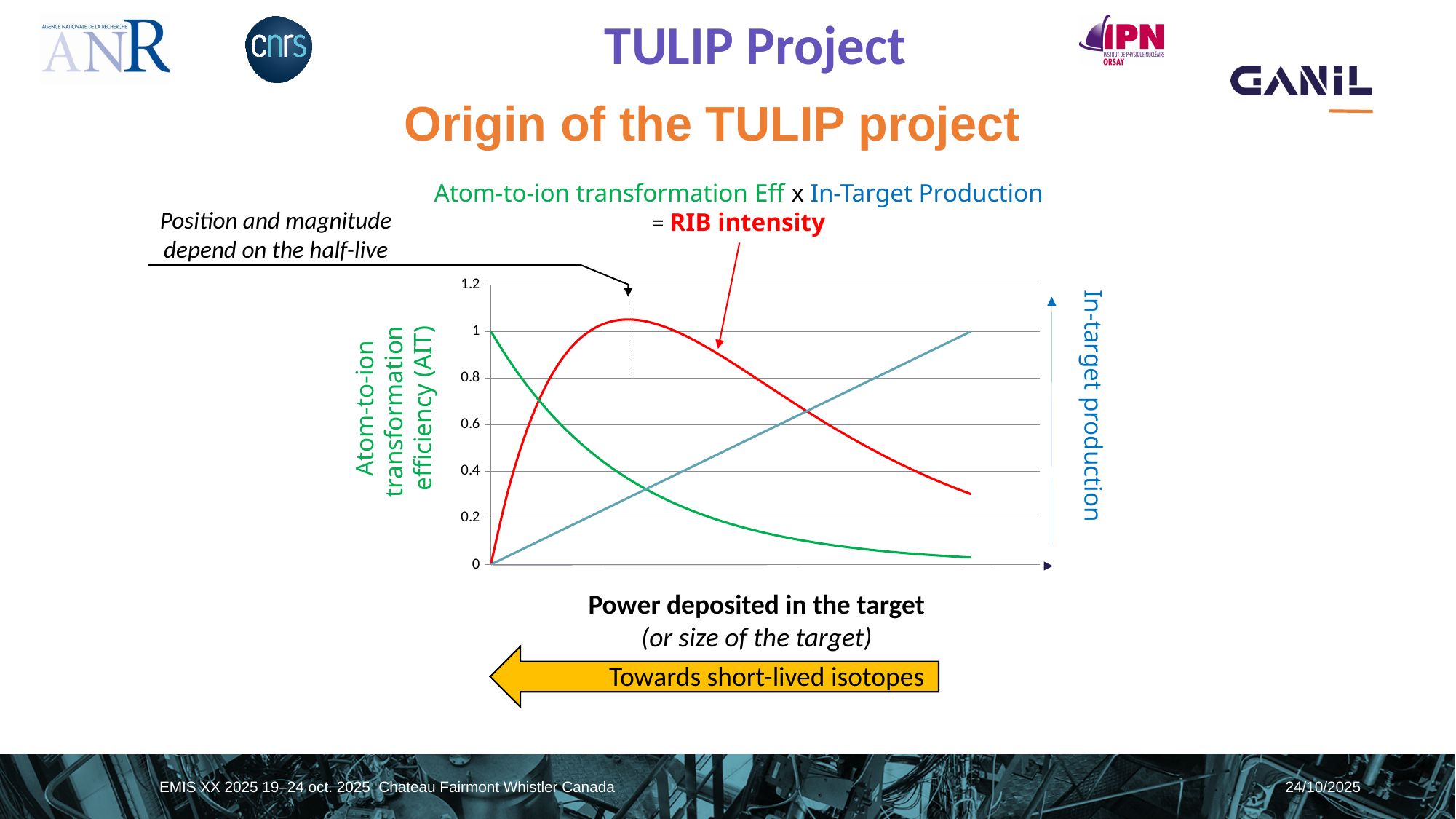
Does the green Atom-to-ion transformation efficiency curve rise or fall as power deposited in the target increases? fall What value does the blue In-target production curve reach at the right end of the chart? 1 Is the peak of the red RIB intensity curve greater or less than 0.8? greater Is the value of the red RIB intensity curve at the right end of the chart greater or less than 0.6? less Which curve is higher at the right end of the chart, the red RIB intensity curve or the green Atom-to-ion transformation efficiency curve? red RIB intensity curve What is the label of the horizontal axis of the chart? Power deposited in the target How many curves are plotted on the chart? 3 What is the highest tick value shown on the left vertical axis? 1.2 Does the blue In-target production curve rise or fall along the x axis? rise Is the value of the green curve at the right end of the chart greater or less than 0.2? less What is the value of the green Atom-to-ion transformation efficiency curve at the left edge of the chart? 1 What kind of chart is shown on the slide? line chart